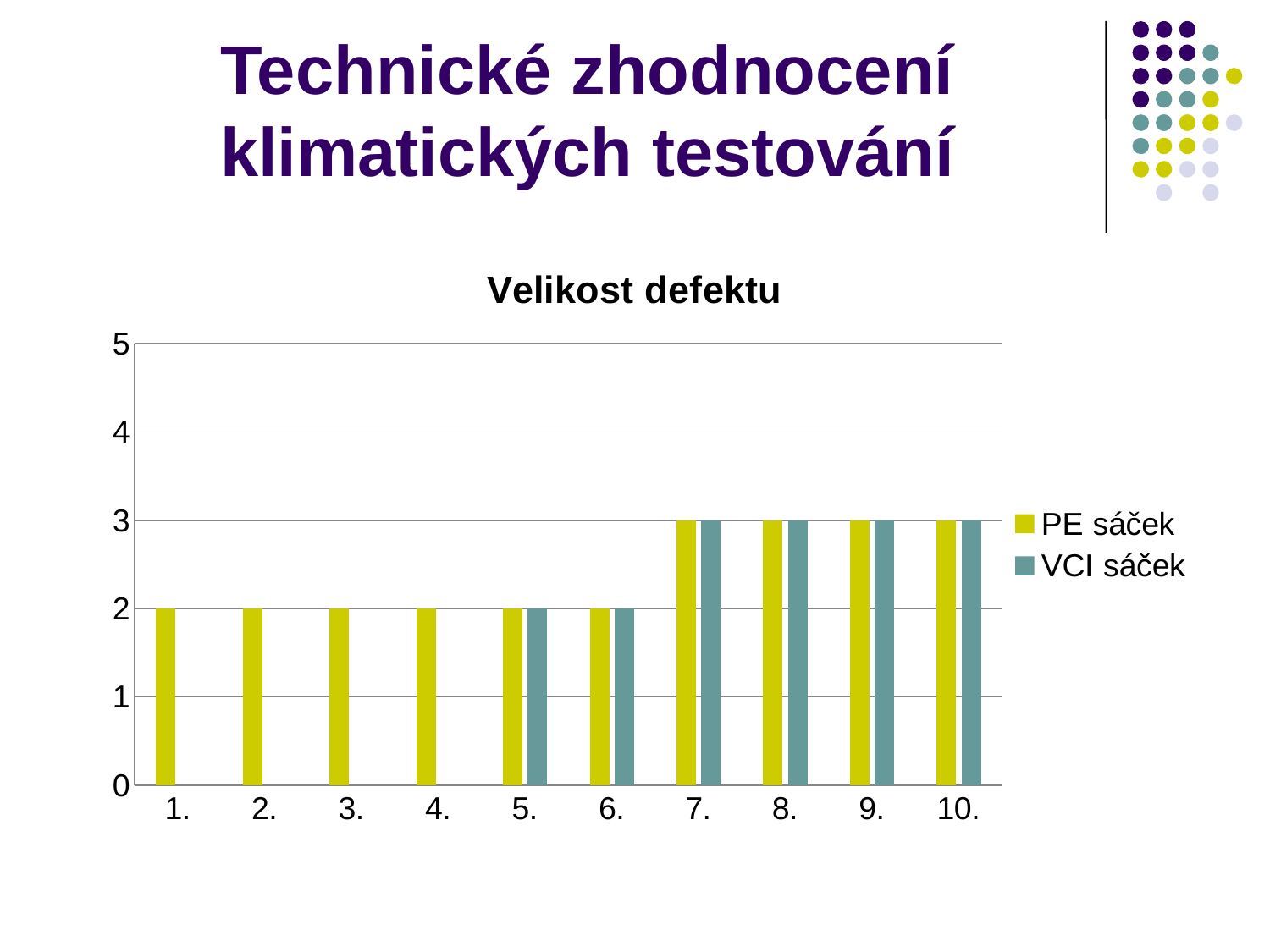
What is the value for PE sáček at category 7.? 3 What kind of chart is shown on the slide? bar chart What is the value for VCI sáček at category 10.? 3 How many categories are shown on the x axis? 10 Is the value for PE sáček at category 4. greater or less than 3? less Do the PE sáček values rise or fall from category 1. to category 10.? rise How many series does the legend list? 2 What is the value for PE sáček at category 1.? 2 What is the difference between the PE sáček value at category 8. and the PE sáček value at category 2.? 1 Which is larger, the PE sáček value at category 9. or the PE sáček value at category 3.? PE sáček at category 9. What is the value for VCI sáček at category 5.? 2 What is the title of the chart? Velikost defektu